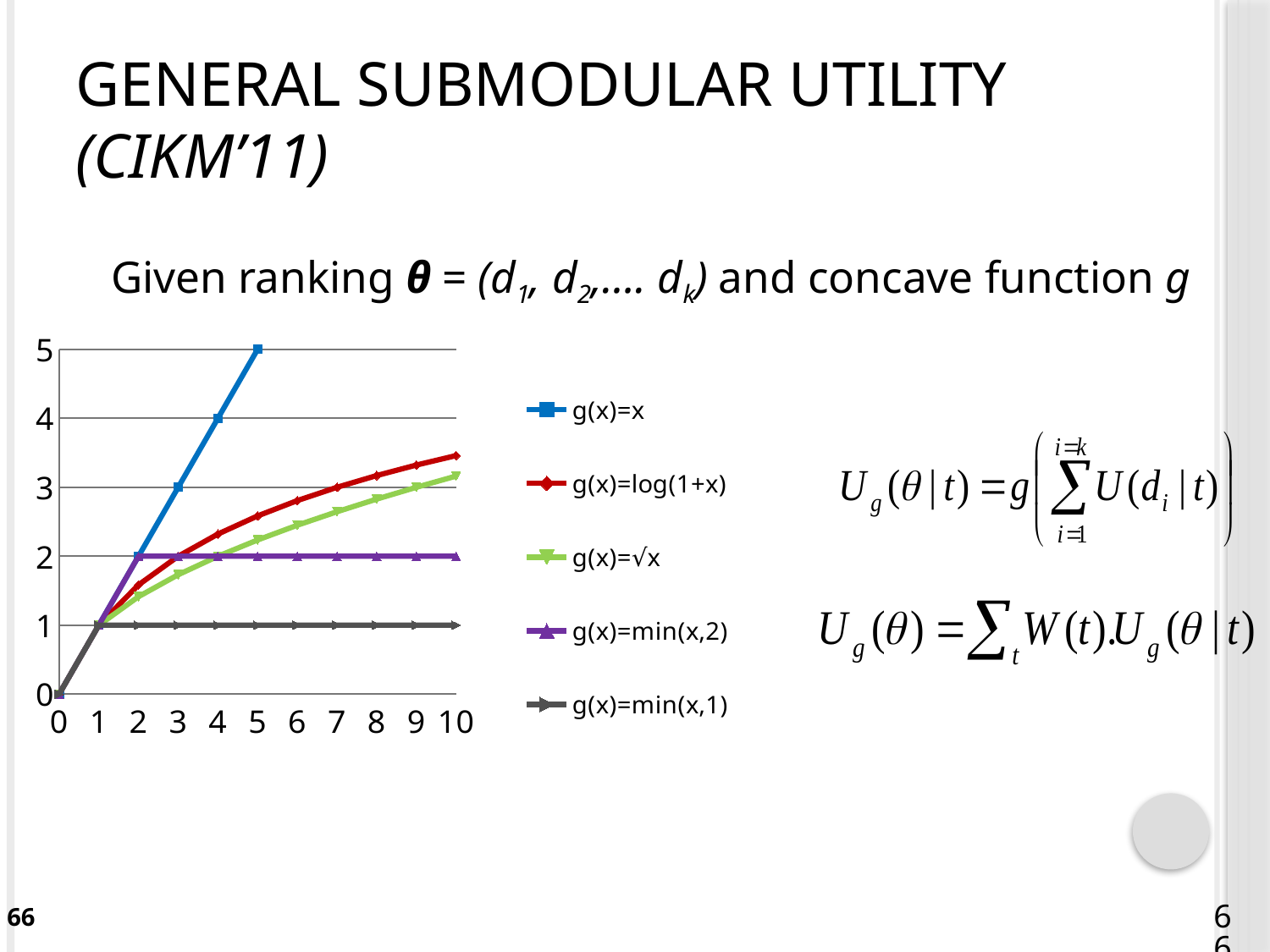
What kind of chart is shown on the slide? line chart Which series has the lowest value at x=10? g(x)=min(x,1) Does the g(x)=min(x,1) series rise, fall, or stay flat between x=1 and x=10? stays flat What is the value of g(x)=x at x=3? 3 What is the value of g(x)=min(x,1) at x=10? 1 What is the value of g(x)=x at x=5? 5 At x=10, is the value of g(x)=log(1+x) greater or less than 3? greater Which series reaches the highest value on the chart? g(x)=x How many series does the chart's legend list? 5 At x=10, which is larger: g(x)=log(1+x) or g(x)=√x? g(x)=log(1+x) What is the value of g(x)=min(x,2) at x=10? 2 What is the difference between g(x)=min(x,2) and g(x)=min(x,1) at x=10? 1